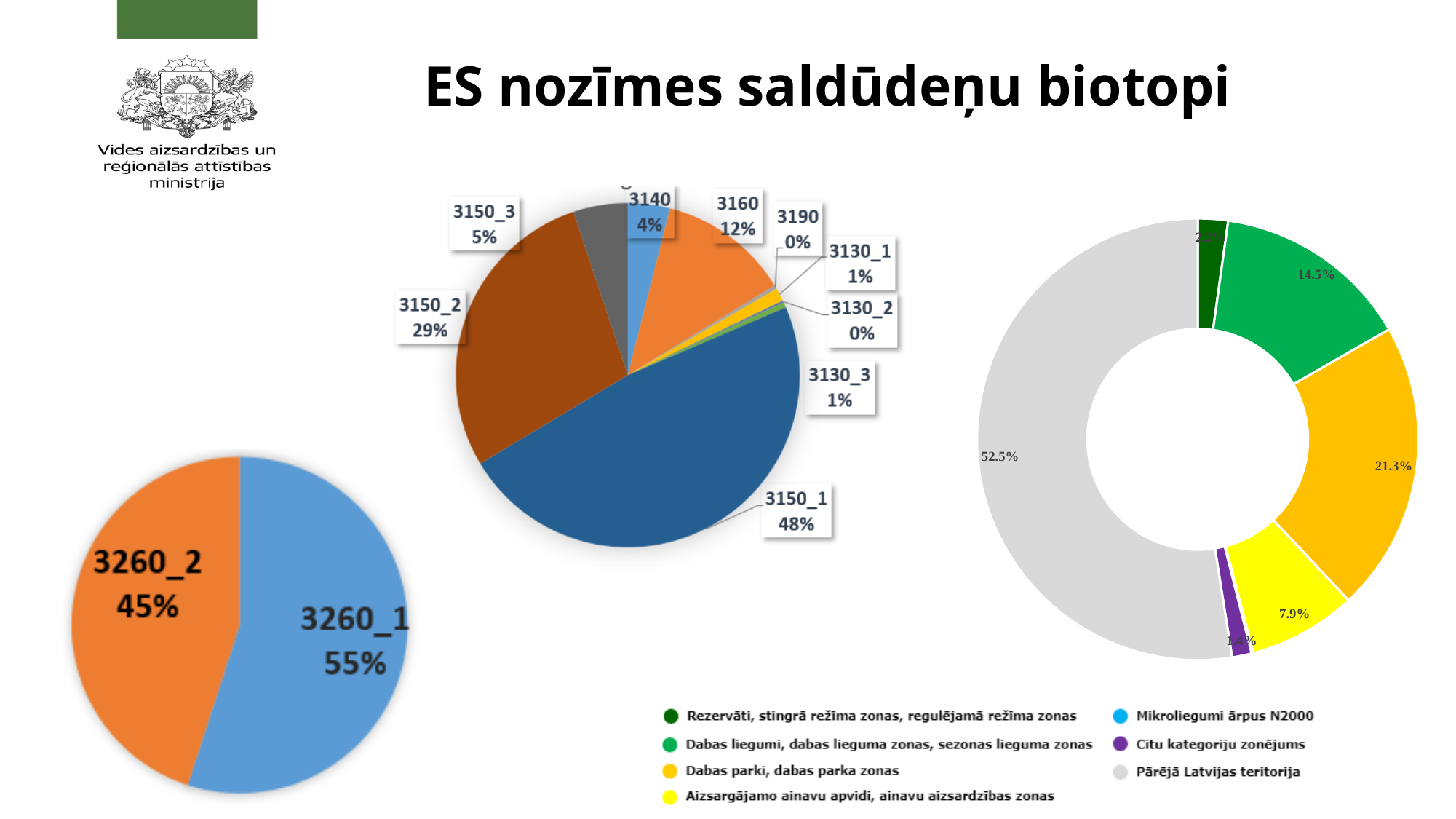
In the left pie chart, what share does 3260_1 have? 55% In the middle pie chart, what is the difference in percentage points between 3150_2 and 3150_3? 24 In the right donut chart, what share is shown for Dabas parki, dabas parka zonas (orange)? 21.3% In the left pie chart, what is the difference in percentage points between 3260_1 and 3260_2? 10 How many entries does the legend of the right donut chart list? 7 In the left pie chart, which of the two slices is larger, 3260_1 or 3260_2? 3260_1 In the middle pie chart, what share does 3150_1 have? 48% In the right donut chart, what share is shown for Pārējā Latvijas teritorija (grey)? 52.5% In the middle pie chart, what share does 3160 have? 12% In the middle pie chart, which category has the largest share? 3150_1 In the middle pie chart, how many categories are labelled? 9 In the left pie chart, what share does 3260_2 have? 45%